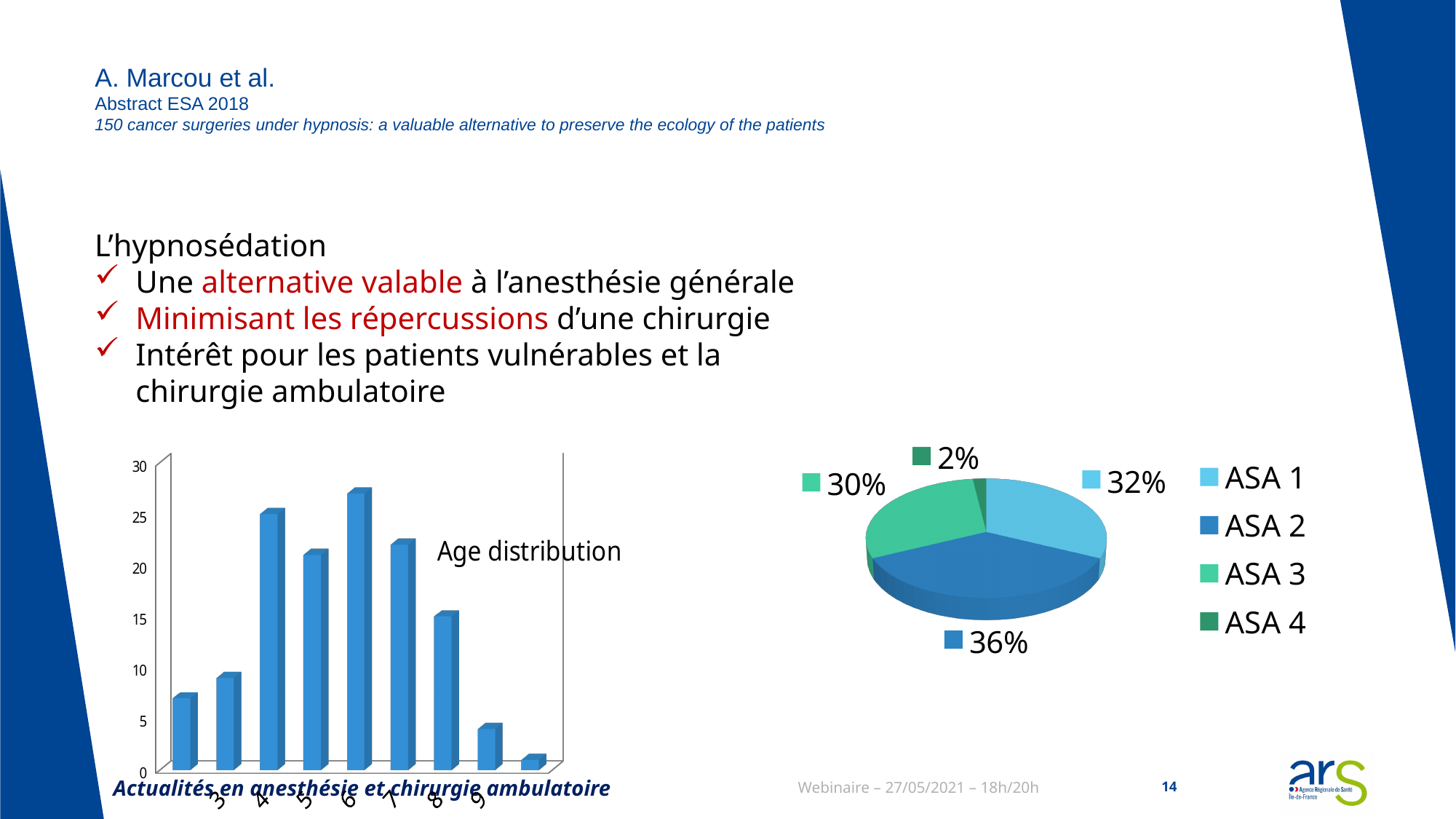
In the pie chart, which has the larger share, ASA 1 or ASA 3? ASA 1 How many bars are plotted in the 'Age distribution' chart? 9 What kind of chart is the 'Age distribution' chart? Bar chart In the pie chart, what percentage is shown for ASA 2? 36% In the pie chart, what percentage is shown for ASA 1? 32% What kind of chart is the chart on the right of the slide? Pie chart In the pie chart, what percentage is shown for ASA 4? 2% In the pie chart, which ASA class has the largest share? ASA 2 In the pie chart, which ASA class has the smallest share? ASA 4 How many entries does the legend of the pie chart list? 4 In the 'Age distribution' chart, is the value of the tallest bar greater or less than 25? greater In the pie chart, what is the difference in percentage points between ASA 2 and ASA 3? 6